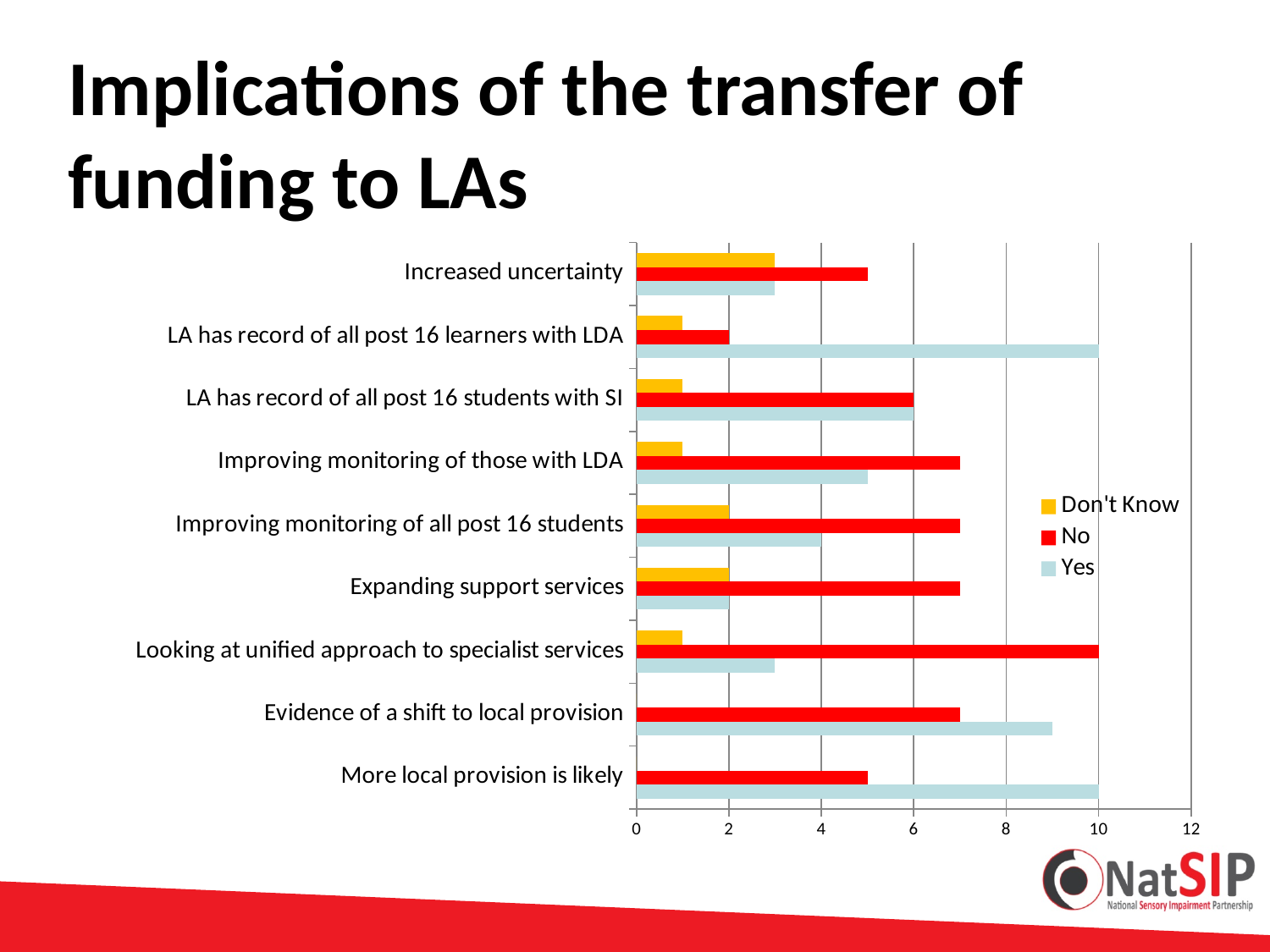
What type of chart is shown on the slide? bar chart Is the 'Yes' value for 'Evidence of a shift to local provision' greater or less than 8? greater Which category has the highest 'No' value? Looking at unified approach to specialist services What is the difference between the 'Yes' and 'No' values for 'LA has record of all post 16 learners with LDA'? 8 How many series does the legend list? 3 What is the 'Yes' value for 'LA has record of all post 16 learners with LDA'? 10 What is the 'No' value for 'LA has record of all post 16 students with SI'? 6 What is the 'No' value for 'Looking at unified approach to specialist services'? 10 How many categories are plotted on the chart? 9 What is the 'Yes' value for 'Improving monitoring of all post 16 students'? 4 Which colour represents the 'No' series in the legend? red For 'LA has record of all post 16 learners with LDA', which is larger, the 'Yes' value or the 'No' value? Yes